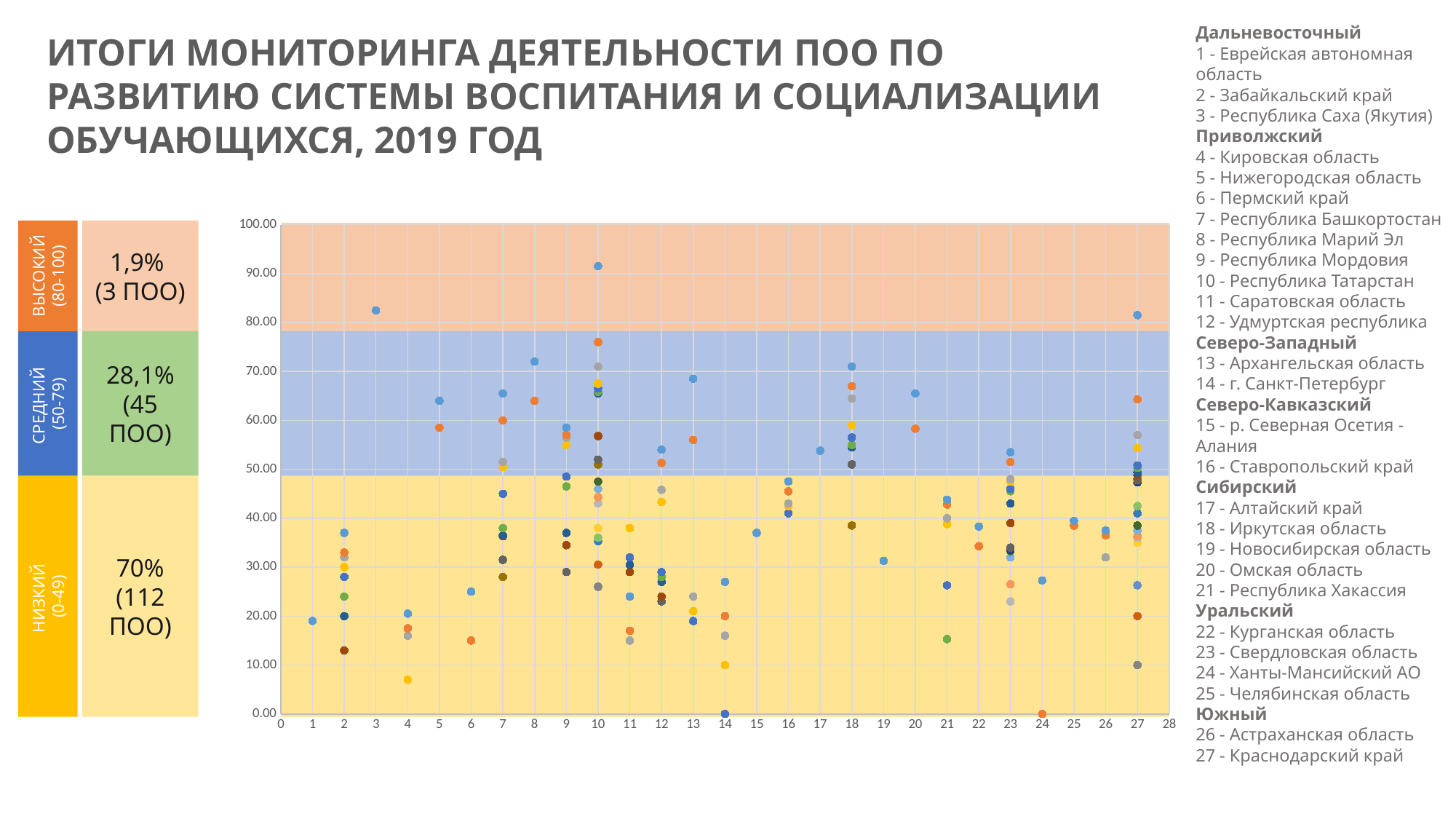
Is the point at x-axis position 17 greater or less than 50? greater Is the point at x-axis position 15 greater or less than 40? less What is the maximum value shown on the vertical axis of the chart? 100.00 Is the point at x-axis position 3 greater or less than 70? greater Which is larger: the point at x-axis position 1 or the point at x-axis position 15? position 15 What is the highest value labelled on the horizontal axis of the chart? 28 At which x-axis position is the highest point on the chart located? 10 Which is larger: the highest point at x-axis position 10 or the point at x-axis position 3? position 10 What kind of chart is shown on the slide? scatter chart